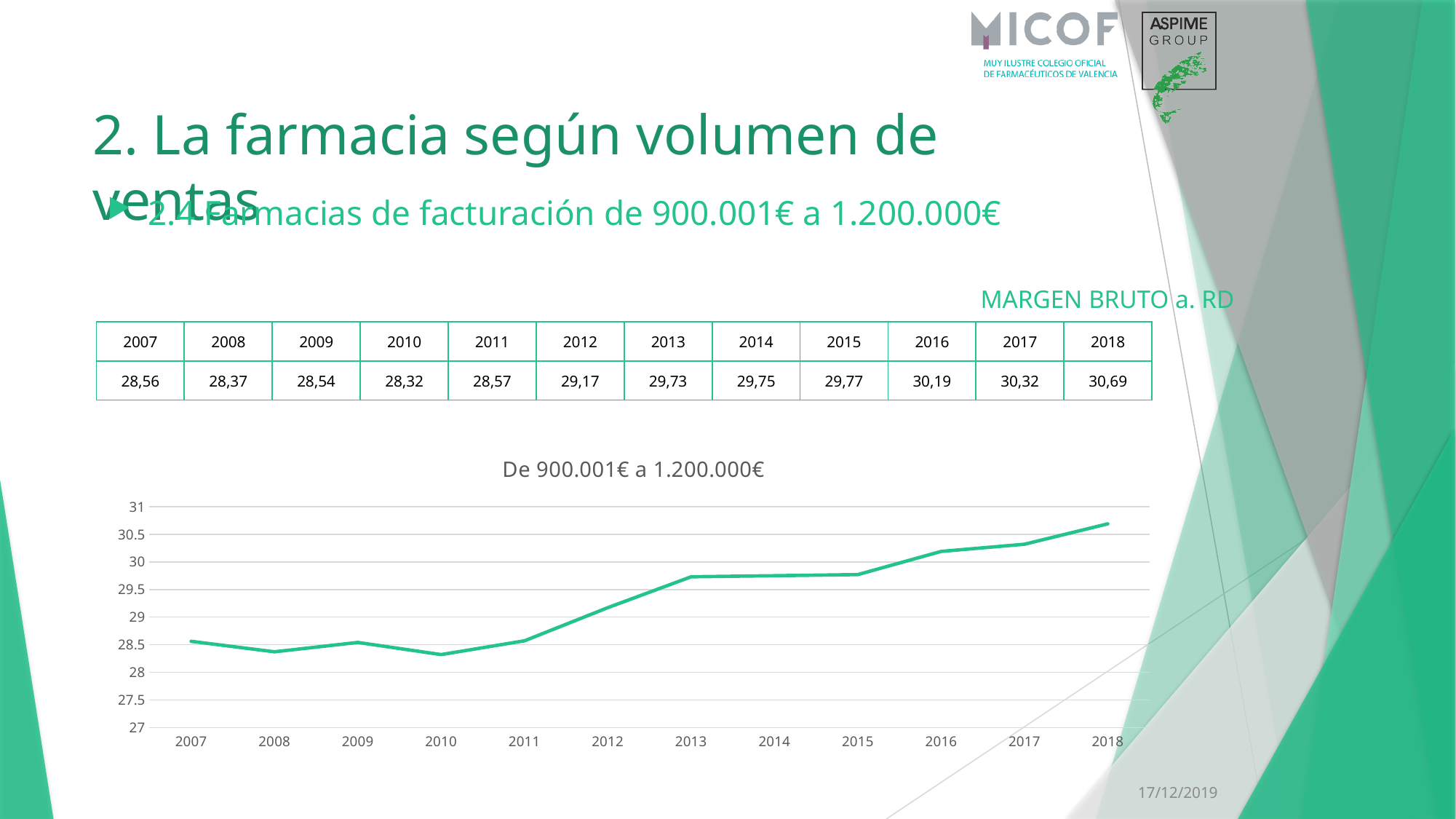
What is the value for 2018? 30,69 What is the value for 2007? 28,56 Is the value for 2010 greater or less than 28.5? less Which year has the highest value in the chart? 2018 What is the value for 2013? 29,73 Is the value for 2013 greater or less than 29.5? greater Overall, do the values rise or fall from 2007 to 2018? rise How many years are plotted along the x axis of the chart? 12 Which year has the lowest value in the chart? 2010 What type of chart is shown on the slide? line chart What is the difference between the values for 2018 and 2007? 2,13 What is the title of the chart? De 900.001€ a 1.200.000€